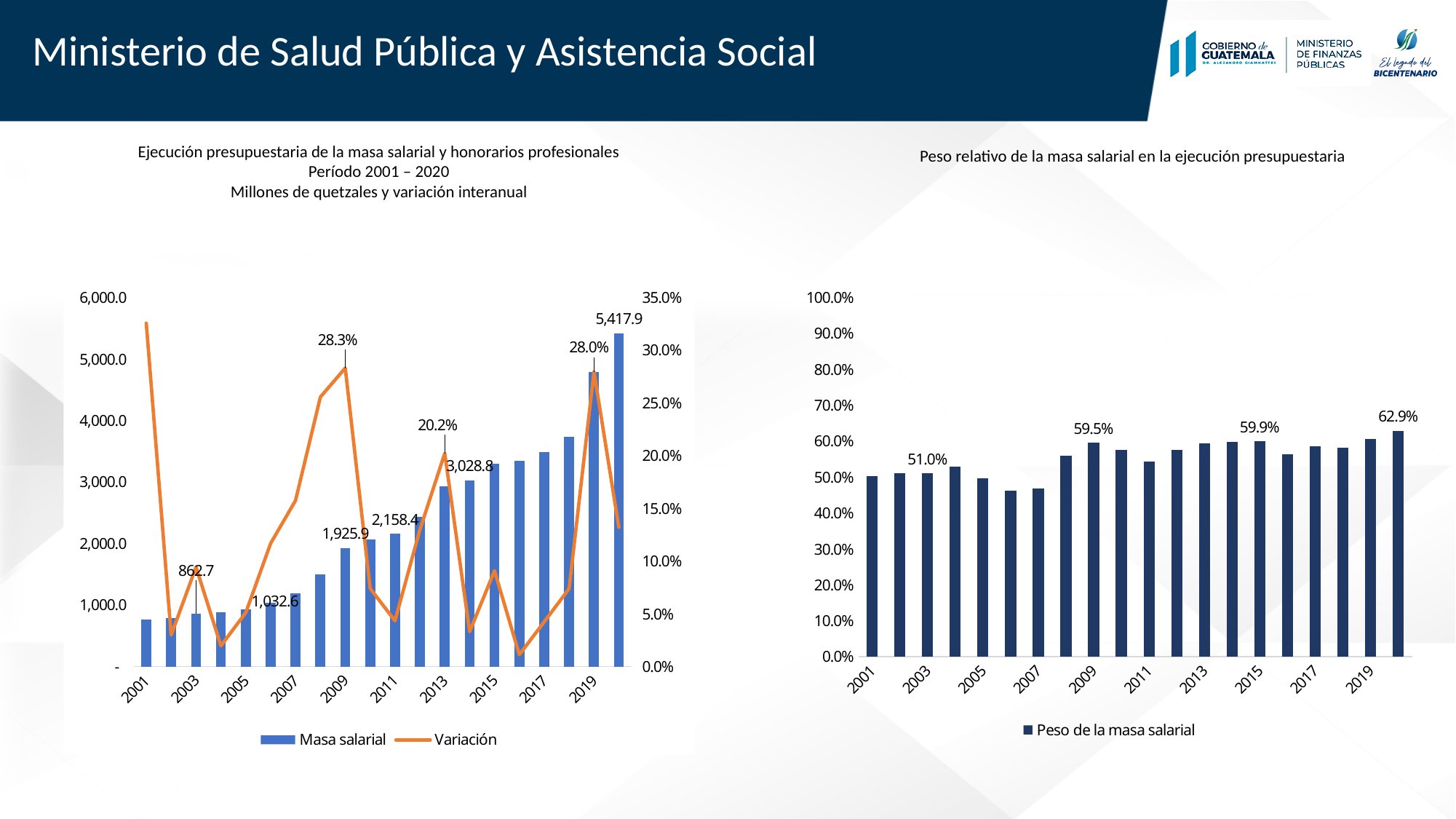
What kind of chart is the right chart (Peso relativo de la masa salarial)? Bar chart How many series does the legend of the left chart list? 2 In the right chart, is the value for 2006 greater or less than 50.0%? less In the right chart (Peso relativo de la masa salarial), what is the value for 2020? 62.9% In the left chart (Ejecución presupuestaria de la masa salarial), what is the Masa salarial value for 2020? 5,417.9 In the left chart, what is the Masa salarial value for 2003? 862.7 In the right chart, what is the difference between the values for 2020 and 2003? 11.9% In the left chart, what is the Masa salarial value for 2009? 1,925.9 In the left chart, which year has the highest Masa salarial bar? 2020 In the left chart, is the Masa salarial value for 2001 greater or less than 1,000.0? less In the left chart, what is the Variación value labelled for 2009? 28.3% In the left chart, what is the difference between the Masa salarial values for 2020 and 2003? 4,555.2